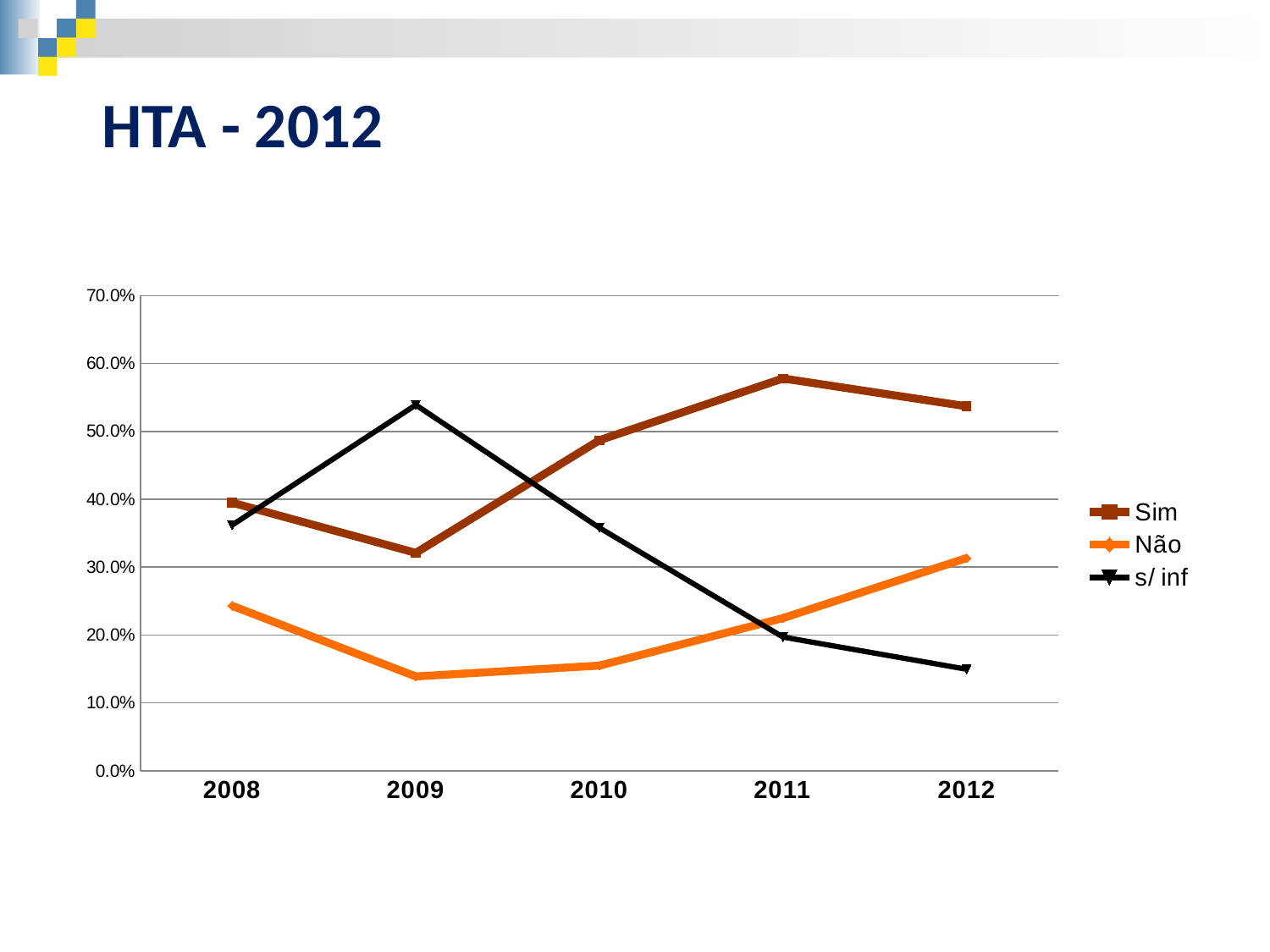
What kind of chart is shown on the slide? line chart Is the value for s/ inf in 2009 greater or less than 50.0%? greater How many years are plotted along the x axis? 5 Does the s/ inf series rise or fall from 2009 to 2012? fall Is the value for Não in 2009 greater or less than 20.0%? less In which year does the Sim series reach its highest value? 2011 In which year does the s/ inf series reach its lowest value? 2012 In 2009, which series has the larger value, s/ inf or Sim? s/ inf Is the value for Sim in 2011 greater or less than 50.0%? greater What is the title of the slide containing the chart? HTA - 2012 How many series does the legend list? 3 In 2012, which series has the larger value, Sim or Não? Sim